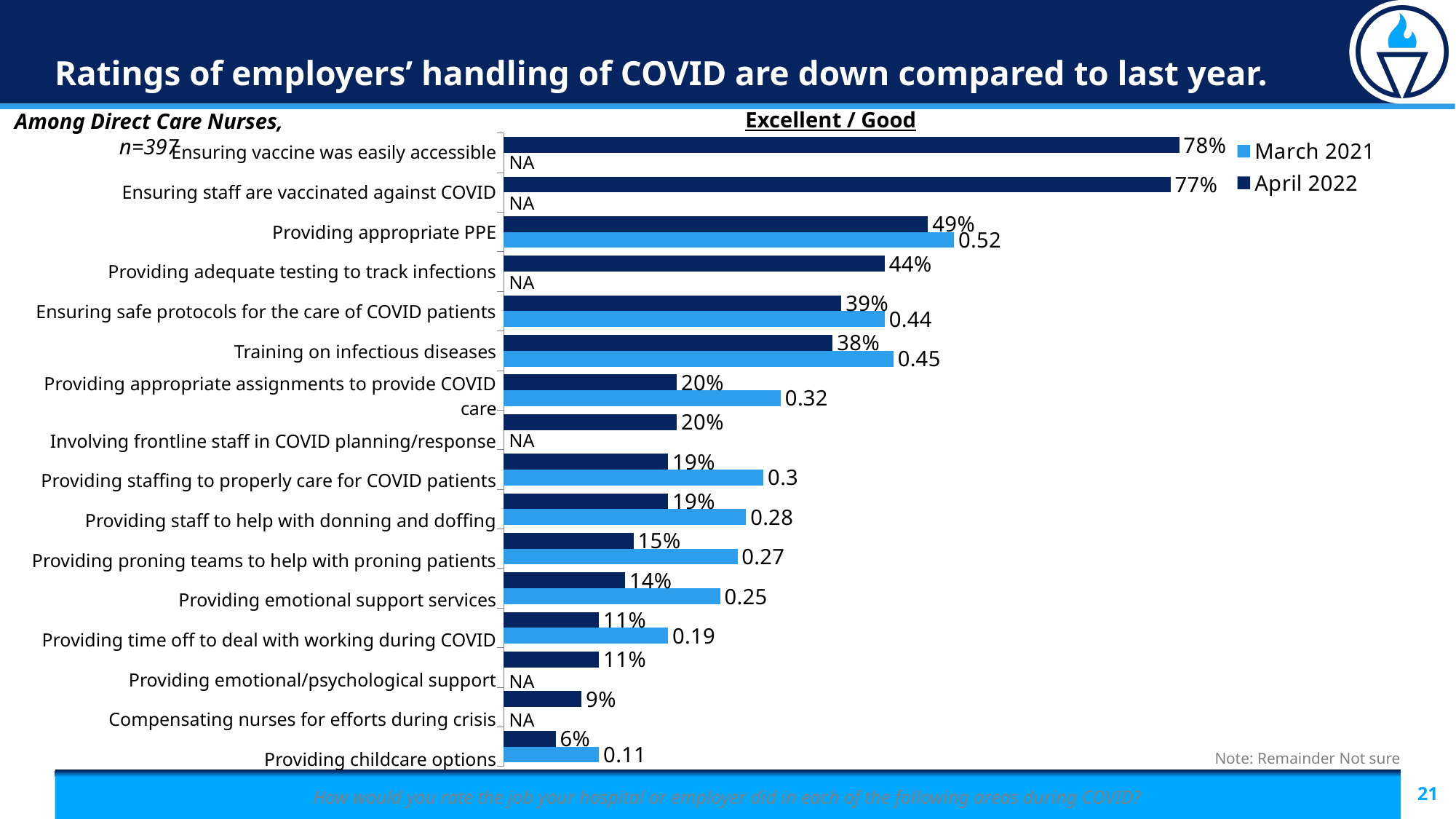
Which category has the highest April 2022 value? Ensuring vaccine was easily accessible What are the two series listed in the chart legend? March 2021 and April 2022 How many series does the legend list? 2 Which category has the lowest April 2022 value? Providing childcare options For Training on infectious diseases, which is larger: the March 2021 value or the April 2022 value? March 2021 What is the April 2022 value for Providing emotional support services? 14% What kind of chart is shown on the slide? Bar chart What is the April 2022 value for Providing appropriate PPE? 49% What is the difference between the April 2022 values for Providing appropriate PPE and Providing adequate testing to track infections? 5 percentage points What is the March 2021 value shown for Providing adequate testing to track infections? NA How many categories are shown on the chart? 16 What is the March 2021 value for Providing appropriate PPE? 0.52